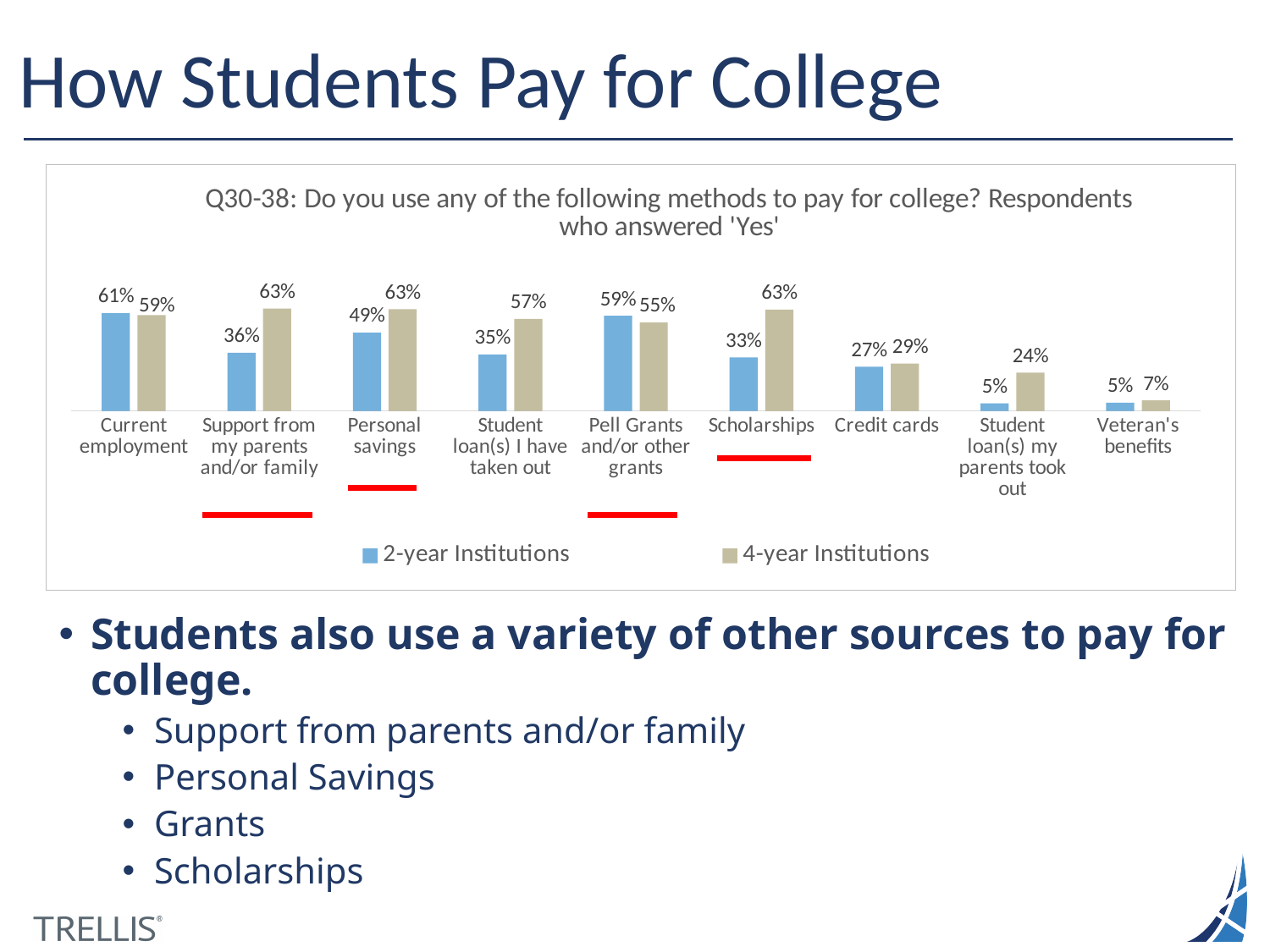
What percentage of 2-year institution respondents use current employment to pay for college? 61% What is the value for 2-year institutions for student loan(s) I have taken out? 35% For Pell Grants and/or other grants, which is larger: 2-year institutions or 4-year institutions? 2-year Institutions Which category has the highest value for 2-year institutions? Current employment What is the difference between 4-year and 2-year institutions for support from my parents and/or family? 27% What is the value for 4-year institutions for Veteran's benefits? 7% Which category has the lowest value for 4-year institutions? Veteran's benefits How many payment method categories are shown on the x axis? 9 How many series does the legend list? 2 What kind of chart is shown on the slide? Bar chart What is the difference between 4-year and 2-year institutions for scholarships? 30% What percentage of 4-year institution respondents use support from parents and/or family? 63%